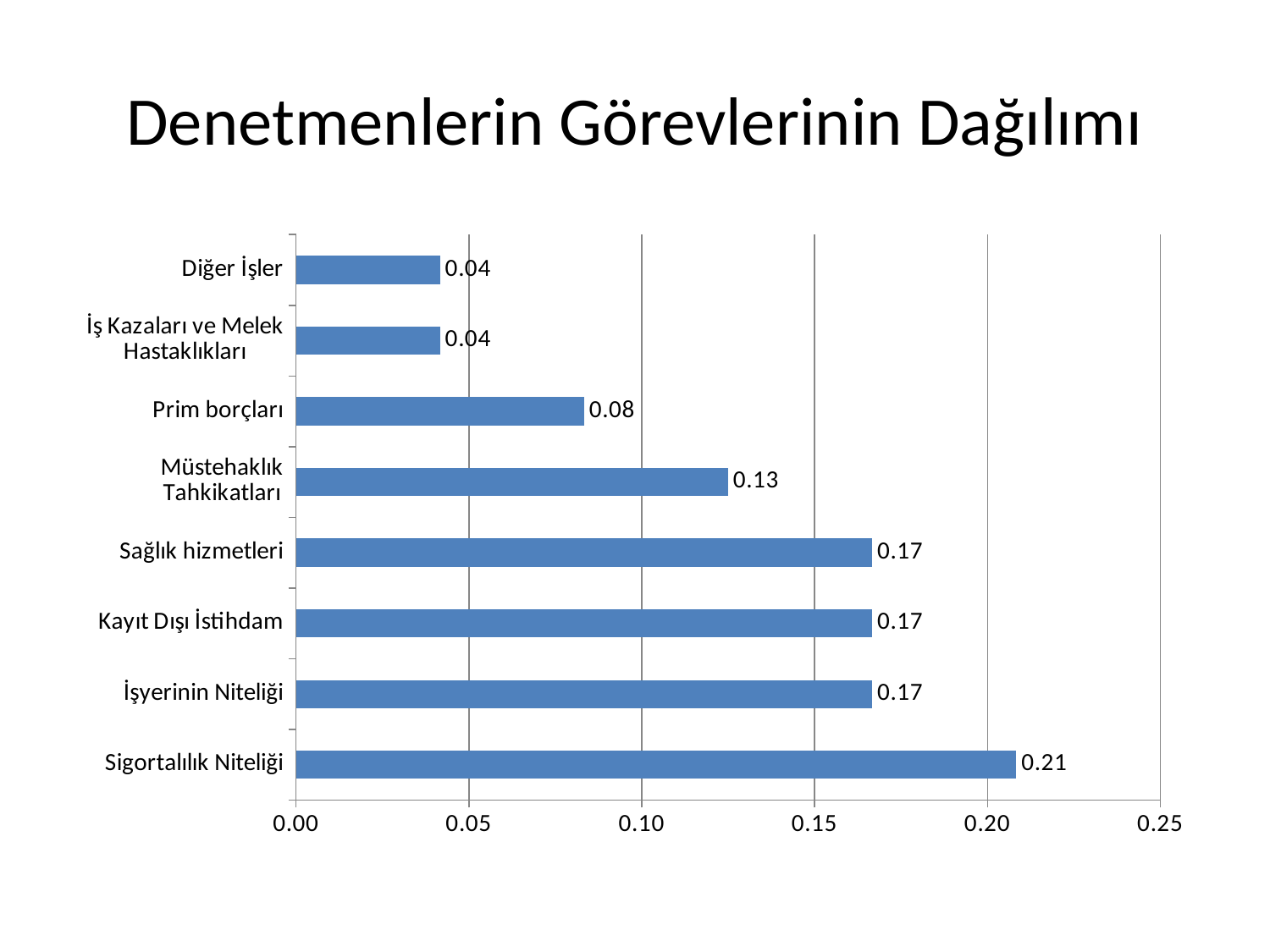
What is the value for Sigortalılık Niteliği? 0.21 How many categories are shown in the chart? 8 What is the difference between the values for Müstehaklık Tahkikatları and Prim borçları? 0.05 Is the value for Sigortalılık Niteliği greater or less than 0.20? greater What is the value for Diğer İşler? 0.04 What is the title of the slide? Denetmenlerin Görevlerinin Dağılımı Which is larger, the value for Prim borçları or the value for Müstehaklık Tahkikatları? Müstehaklık Tahkikatları What is the value for Prim borçları? 0.08 What is the difference between the values for Sigortalılık Niteliği and İşyerinin Niteliği? 0.04 Which category has the highest value? Sigortalılık Niteliği What is the value for Müstehaklık Tahkikatları? 0.13 What kind of chart is shown on the slide? Bar chart